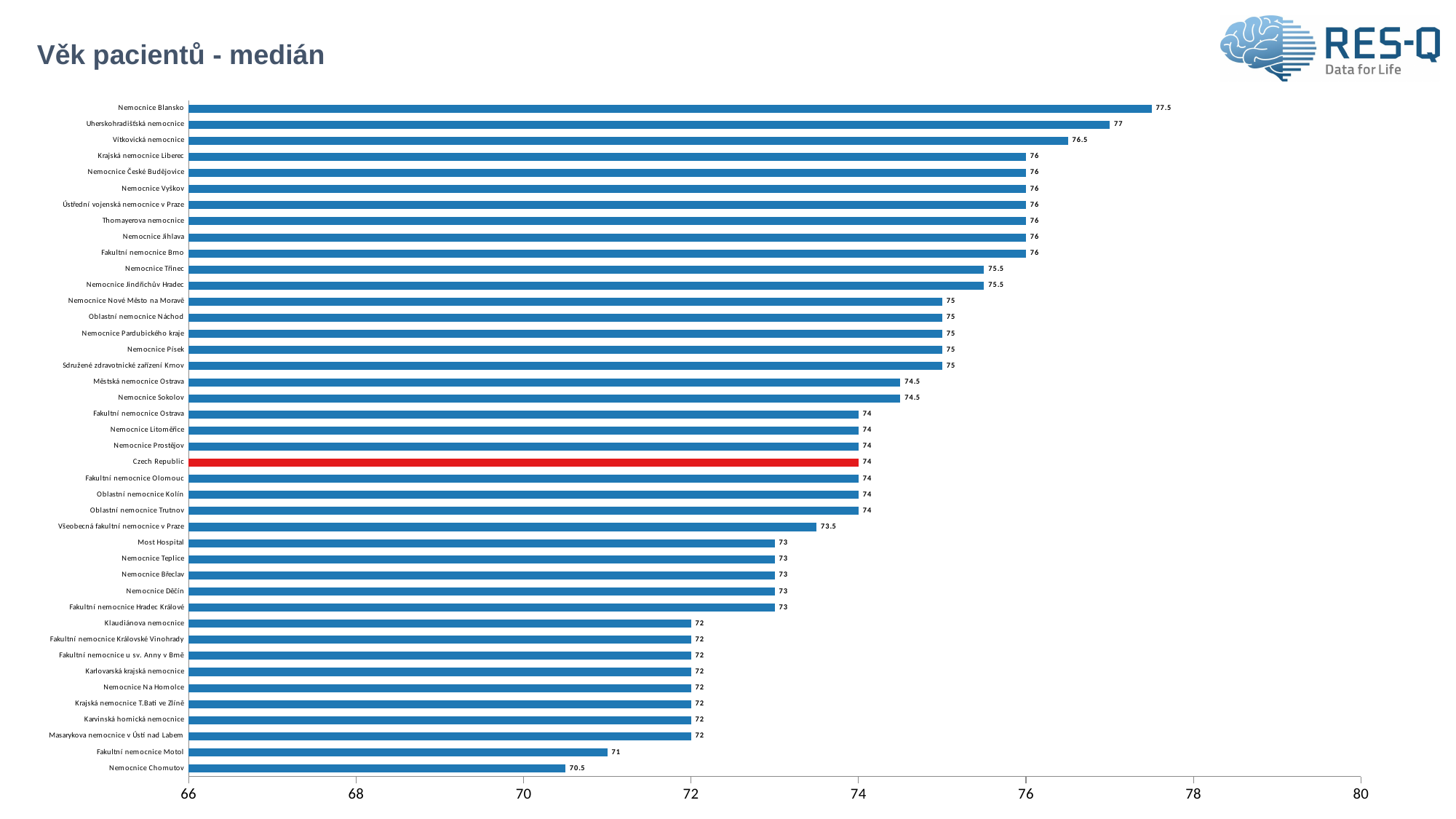
How many bars are shown in the chart? 42 What is the difference between the values for Uherskohradišťská nemocnice and Fakultní nemocnice Motol? 6 What type of chart is shown on the slide? Bar chart What is the median patient age for Nemocnice Blansko? 77.5 Which hospital has the lowest median patient age? Nemocnice Chomutov Which hospital has the highest median patient age? Nemocnice Blansko What is the median patient age for Nemocnice Chomutov? 70.5 What is the value shown for Všeobecná fakultní nemocnice v Praze? 73.5 What is the difference between the values for Nemocnice Blansko and Nemocnice Chomutov? 7 Is the value for Vítkovická nemocnice greater or less than 76? greater What is the value shown for Czech Republic? 74 Which has a higher value, Nemocnice Třinec or Nemocnice Sokolov? Nemocnice Třinec